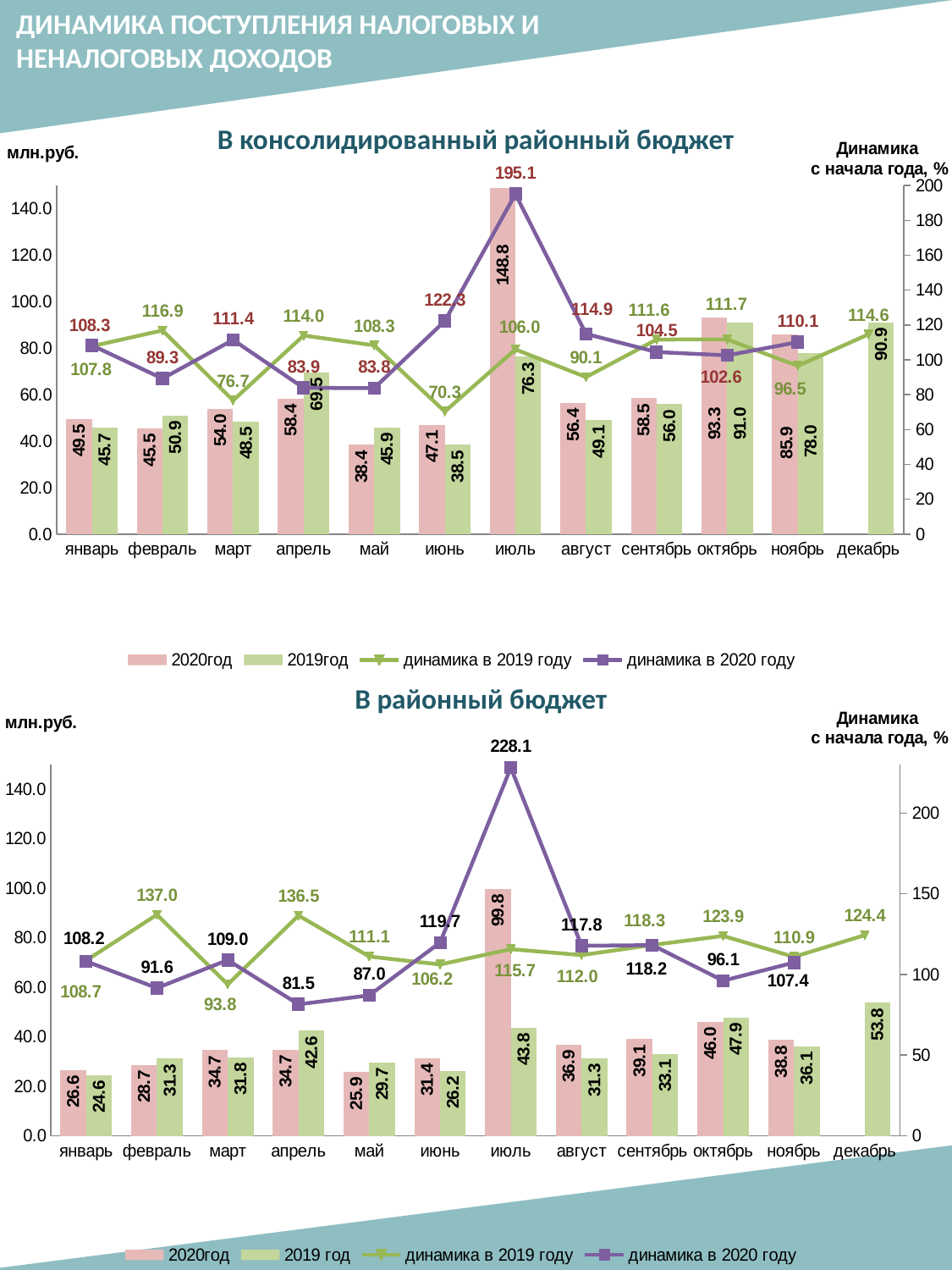
In the chart 'В консолидированный районный бюджет', what is the value of the 2019год bar for декабрь? 90.9 In the chart 'В районный бюджет', which is larger for октябрь: the 2020год bar or the 2019 год bar? 2019 год In the chart 'В консолидированный районный бюджет', which month has the highest value for 'динамика в 2020 году'? июль In the chart 'В районный бюджет', what is the value of the 2019 год bar for апрель? 42.6 What kind of chart is 'В районный бюджет'? Combined bar and line chart In the chart 'В консолидированный районный бюджет', which month has the lowest value for 'динамика в 2019 году'? июнь In the chart 'В консолидированный районный бюджет', what is the value of the 2020год bar for июль? 148.8 In the chart 'В районный бюджет', how many months are shown on the x axis? 12 In the chart 'В консолидированный районный бюджет', how many series does the legend list? 4 In the chart 'В районный бюджет', which month has the lowest 2020год bar? май In the chart 'В консолидированный районный бюджет', what is the difference between the 2020год and 2019год bars for июль? 72.5 In the chart 'В районный бюджет', what is the value of 'динамика в 2020 году' for июль? 228.1